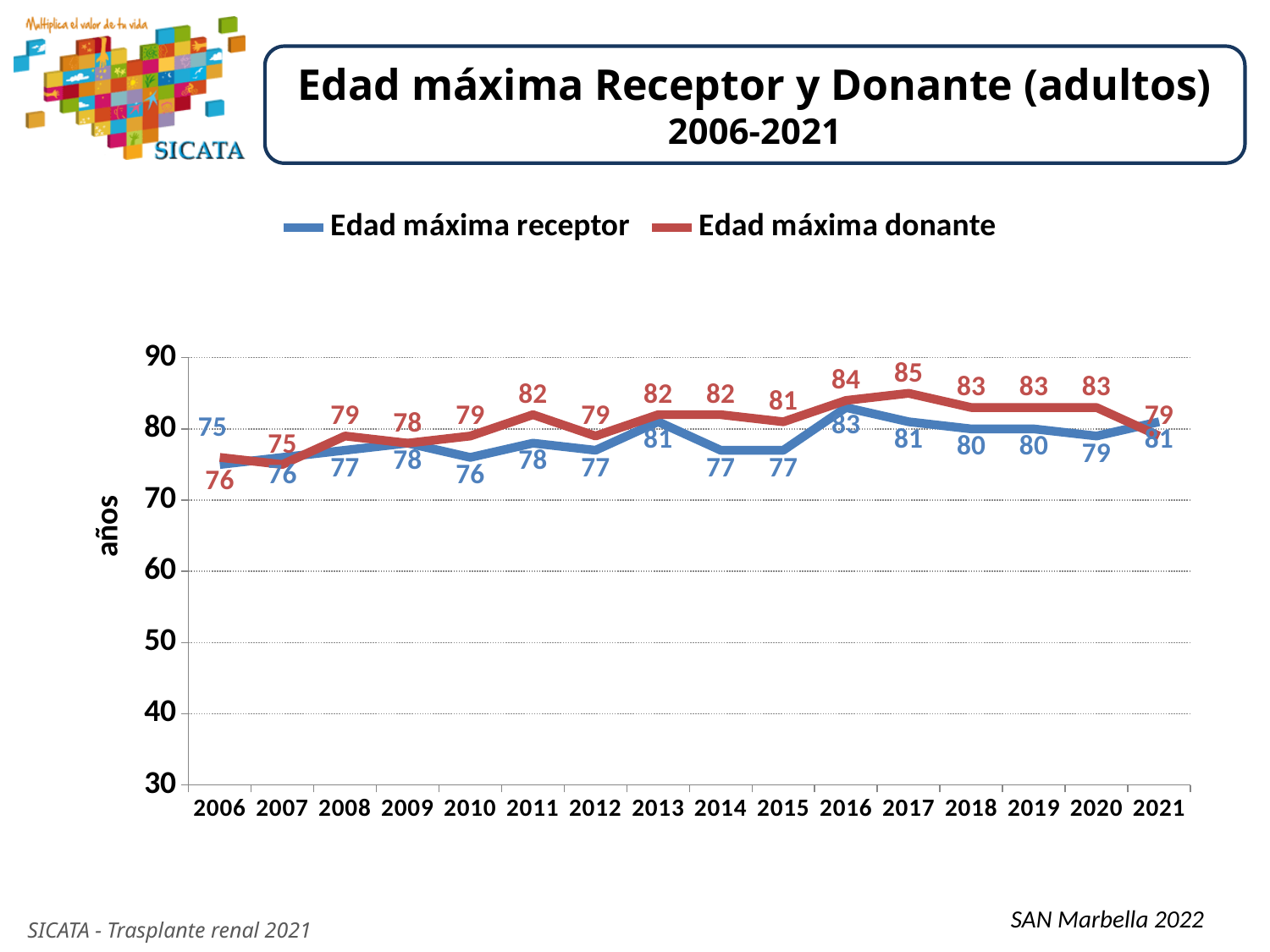
How many years are plotted along the x axis? 16 Is the value of Edad máxima donante in 2016 greater or less than 80? greater How many series does the legend list? 2 What is the difference between Edad máxima donante and Edad máxima receptor in 2015? 4 What is the value of Edad máxima receptor in 2010? 76 Which is larger in 2021, Edad máxima receptor or Edad máxima donante? Edad máxima receptor What is the label on the y axis? años In which year is Edad máxima donante highest? 2017 What is the value of Edad máxima donante in 2017? 85 In which year is Edad máxima receptor lowest? 2006 What type of chart is shown on the slide? line chart What is the value of Edad máxima receptor in 2016? 83